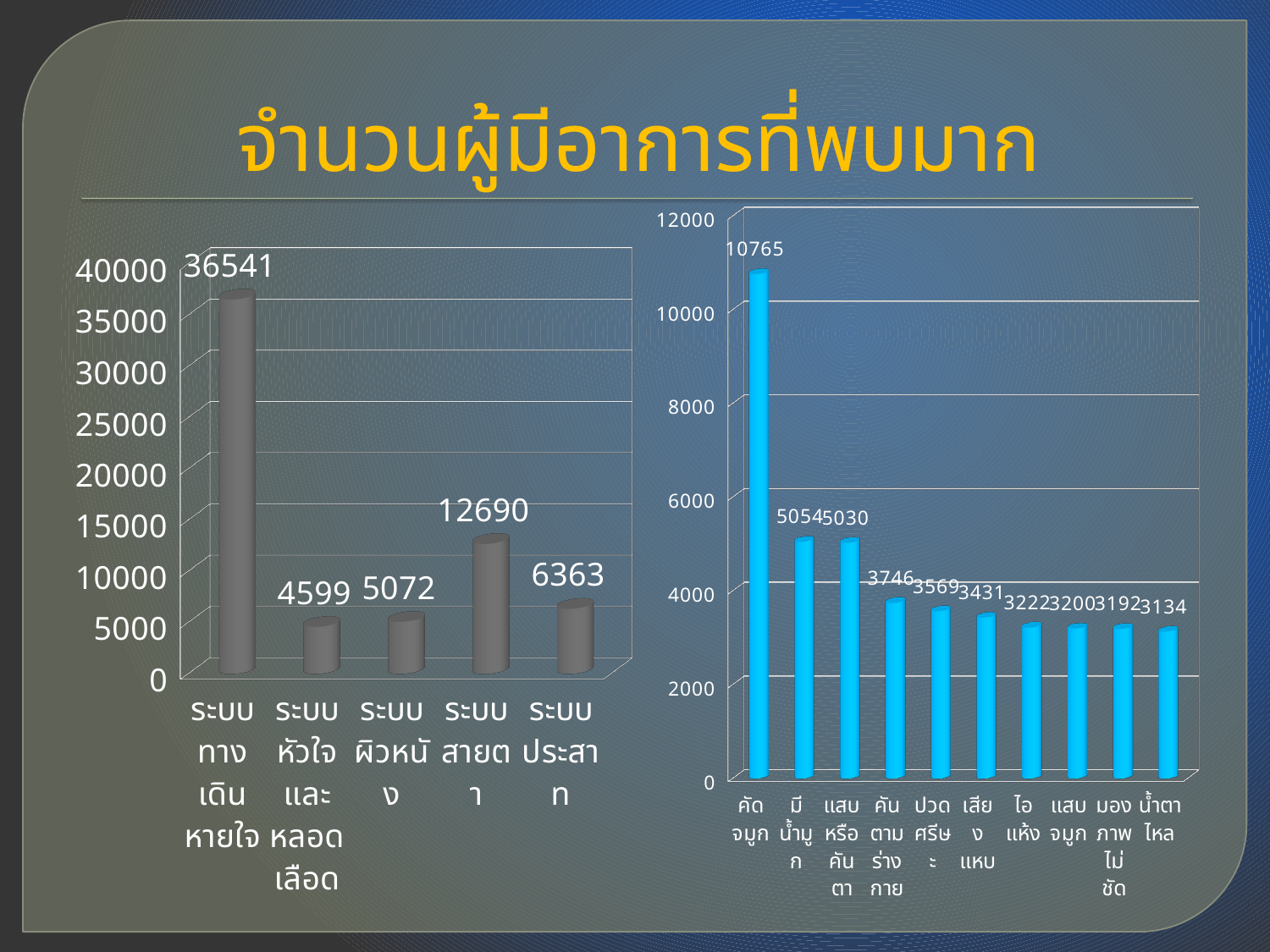
In the right chart, which is larger, มีน้ำมูก or คันตามร่างกาย? มีน้ำมูก In the right chart, which category has the highest value? คัดจมูก In the left chart, what is the difference between ระบบประสาท and ระบบผิวหนัง? 1291 In the right chart, how many categories are shown? 10 In the left chart, which category has the lowest value? ระบบหัวใจและหลอดเลือด In the right chart, what is the difference between คัดจมูก and มีน้ำมูก? 5711 In the right chart, what is the value for น้ำตาไหล? 3134 What is the title of the slide? จำนวนผู้มีอาการที่พบมาก In the left chart, what is the value for ระบบทางเดินหายใจ? 36541 In the left chart, how many categories are shown? 5 In the right chart, what is the value for คัดจมูก? 10765 In the left chart, what is the value for ระบบสายตา? 12690